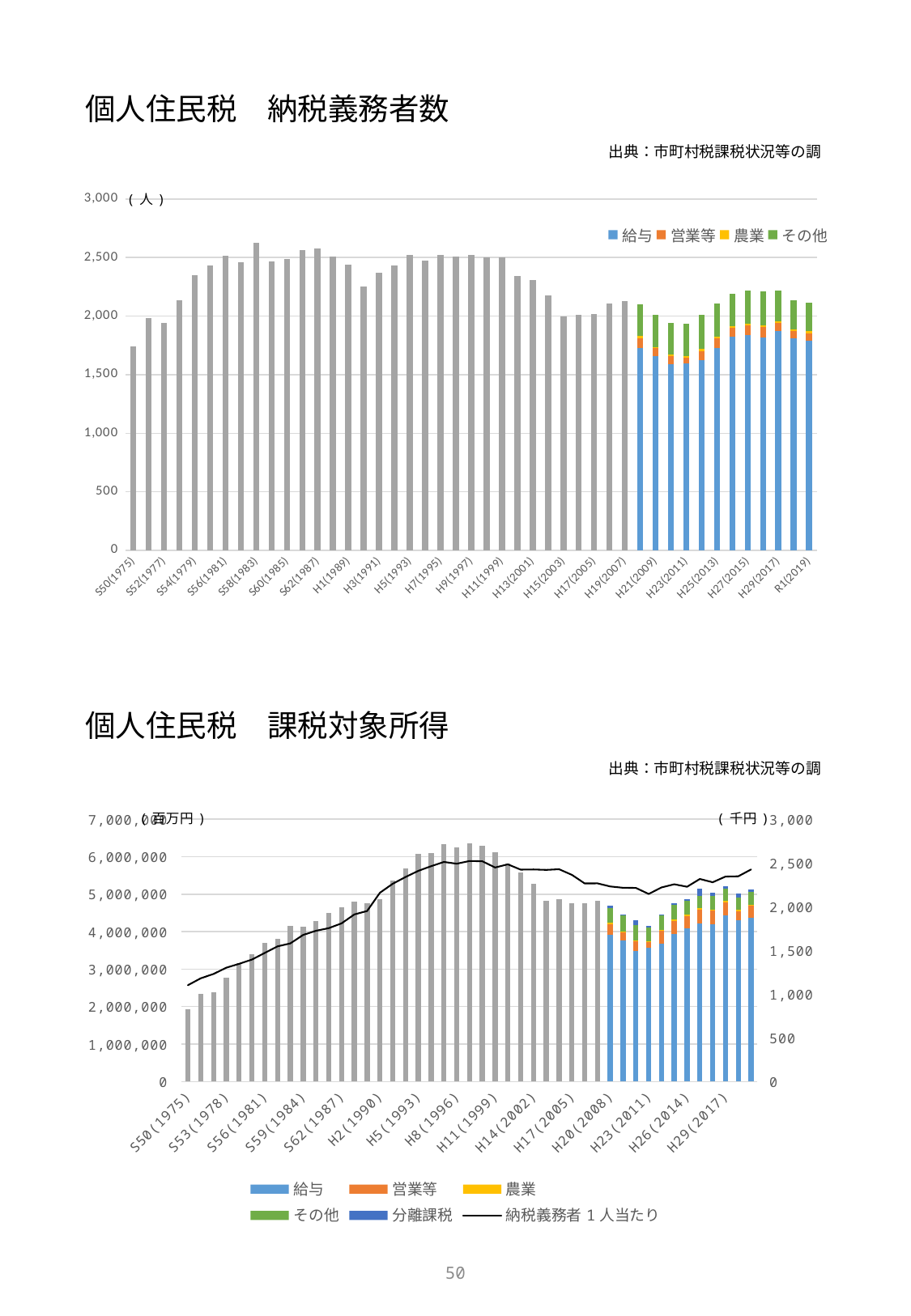
In the bottom chart (個人住民税 課税対象所得), what is the unit shown on the right-hand axis? 千円 In the top chart (個人住民税 納税義務者数), how many series does the legend list? 4 What kind of chart is the top chart titled 個人住民税 納税義務者数? bar chart In the top chart (個人住民税 納税義務者数), is the value for S58(1983) greater or less than 2,500? greater In the bottom chart (個人住民税 課税対象所得), which is larger, the bar value for H5(1993) or H17(2005)? H5(1993) In the top chart (個人住民税 納税義務者数), do the values rise or fall from S50(1975) to S58(1983)? rise In the bottom chart (個人住民税 課税対象所得), how many entries does the legend list? 6 In the top chart (個人住民税 納税義務者数), is the value for S50(1975) greater or less than 2,000? less In the bottom chart (個人住民税 課税対象所得), is the bar value for H8(1996) greater or less than 6,000,000? greater In the top chart (個人住民税 納税義務者数), which year has the lowest total value? S50(1975) In the top chart (個人住民税 納税義務者数), which is larger, the value for S50(1975) or S58(1983)? S58(1983)